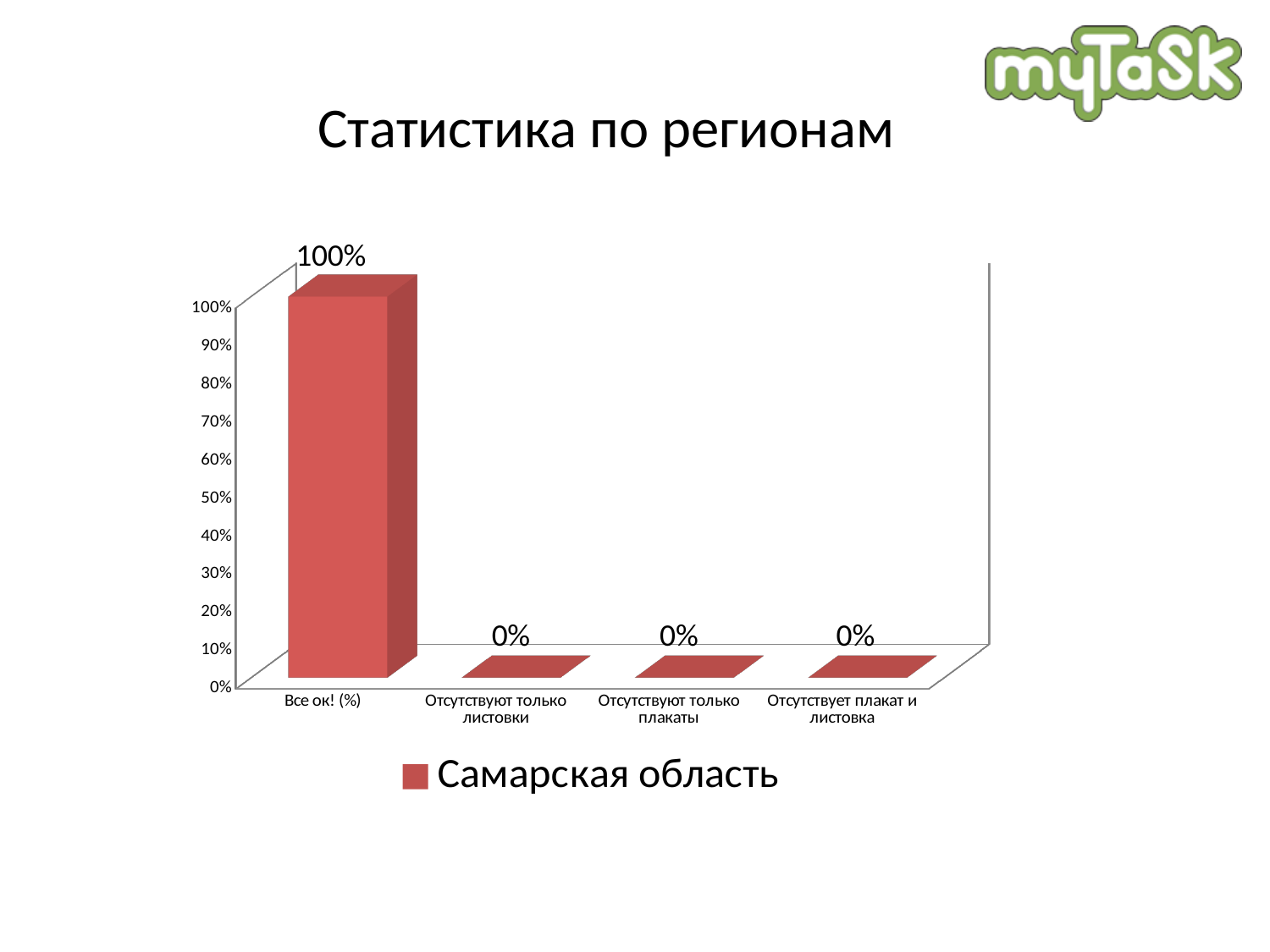
What is the value for "Все ок! (%)"? 100% What is the value for "Отсутствуют только листовки"? 0% What is the difference between the values for "Все ок! (%)" and "Отсутствуют только плакаты"? 100% Which category has the highest value? Все ок! (%) Which is larger, the value for "Все ок! (%)" or the value for "Отсутствуют только листовки"? Все ок! (%) What is the value for "Отсутствуют только плакаты"? 0% What is the name of the series in the legend? Самарская область Is the value for "Все ок! (%)" greater or less than 50%? greater What is the value for "Отсутствует плакат и листовка"? 0% How many categories are shown on the x axis? 4 How many series does the legend list? 1 What kind of chart is shown on the slide? bar chart